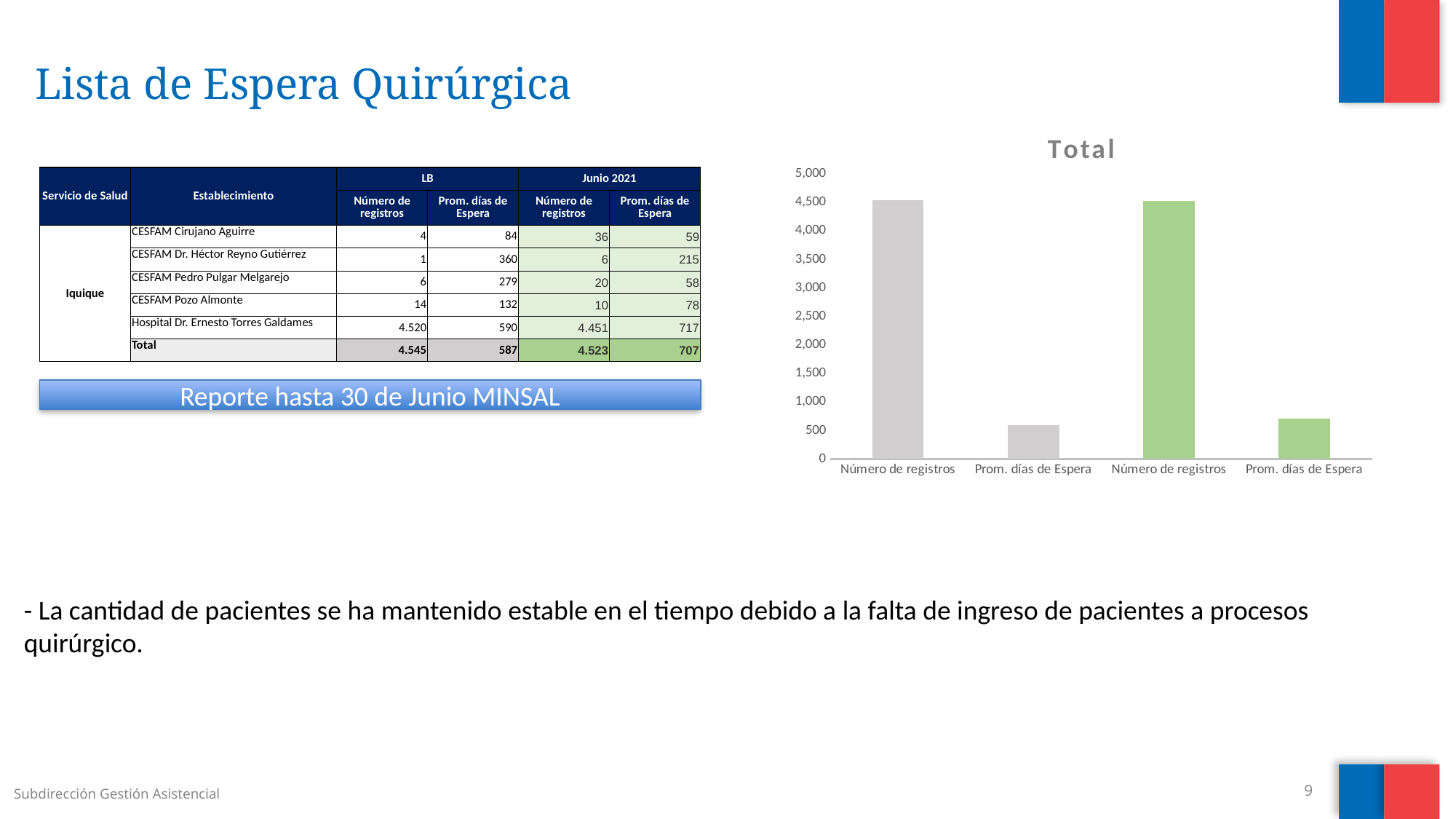
What is the highest value shown on the chart's vertical axis? 5,000 Which is larger: the first grey 'Número de registros' bar or the grey 'Prom. días de Espera' bar next to it? Número de registros Which is larger: the green 'Número de registros' bar or the green 'Prom. días de Espera' bar? Número de registros Is the value of the fourth (rightmost, green) 'Prom. días de Espera' bar greater or less than 1,000? less What is the title of the chart? Total Is the value of the third (green) 'Número de registros' bar greater or less than 4,000? greater Is the value of the first (leftmost, grey) 'Número de registros' bar greater or less than 4,000? greater What kind of chart is shown on the slide? bar chart How many bars does the chart show? 4